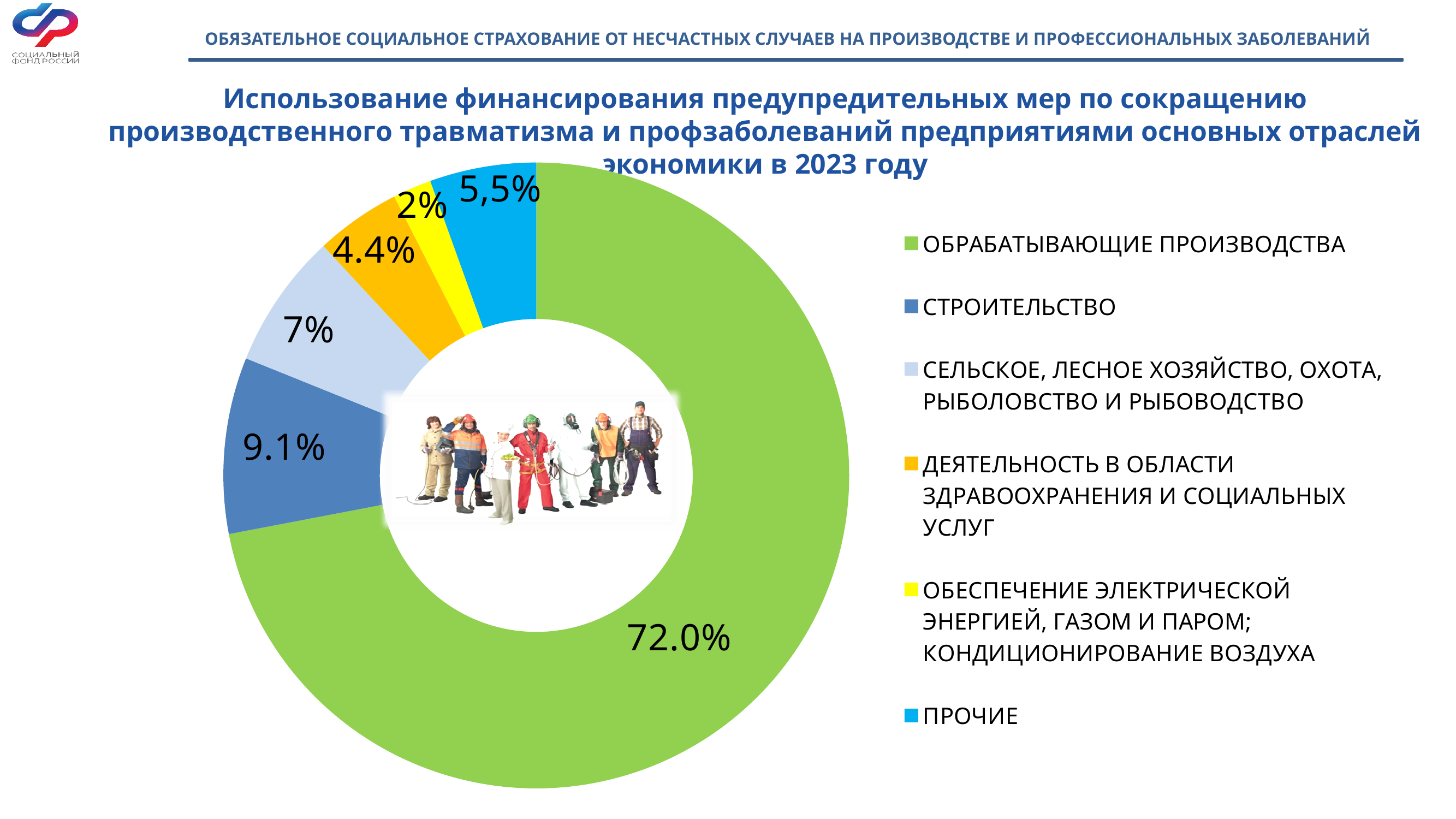
What is the difference in percentage points between СТРОИТЕЛЬСТВО and ДЕЯТЕЛЬНОСТЬ В ОБЛАСТИ ЗДРАВООХРАНЕНИЯ И СОЦИАЛЬНЫХ УСЛУГ? 4.7 Which category has the smallest share of the chart? ОБЕСПЕЧЕНИЕ ЭЛЕКТРИЧЕСКОЙ ЭНЕРГИЕЙ, ГАЗОМ И ПАРОМ; КОНДИЦИОНИРОВАНИЕ ВОЗДУХА How many categories does the chart show? 6 What colour is the slice for ПРОЧИЕ? Bright sky blue (cyan) What is the value shown for ДЕЯТЕЛЬНОСТЬ В ОБЛАСТИ ЗДРАВООХРАНЕНИЯ И СОЦИАЛЬНЫХ УСЛУГ? 4.4% What is the value shown for СТРОИТЕЛЬСТВО? 9.1% What is the value shown for СЕЛЬСКОЕ, ЛЕСНОЕ ХОЗЯЙСТВО, ОХОТА, РЫБОЛОВСТВО И РЫБОВОДСТВО? 7% Which is larger: the share for СТРОИТЕЛЬСТВО or the share for ПРОЧИЕ? СТРОИТЕЛЬСТВО What is the value shown for ПРОЧИЕ? 5,5% What share of the chart does ОБРАБАТЫВАЮЩИЕ ПРОИЗВОДСТВА account for? 72.0% What kind of chart is shown on the slide? Doughnut chart Which category has the largest share of the chart? ОБРАБАТЫВАЮЩИЕ ПРОИЗВОДСТВА